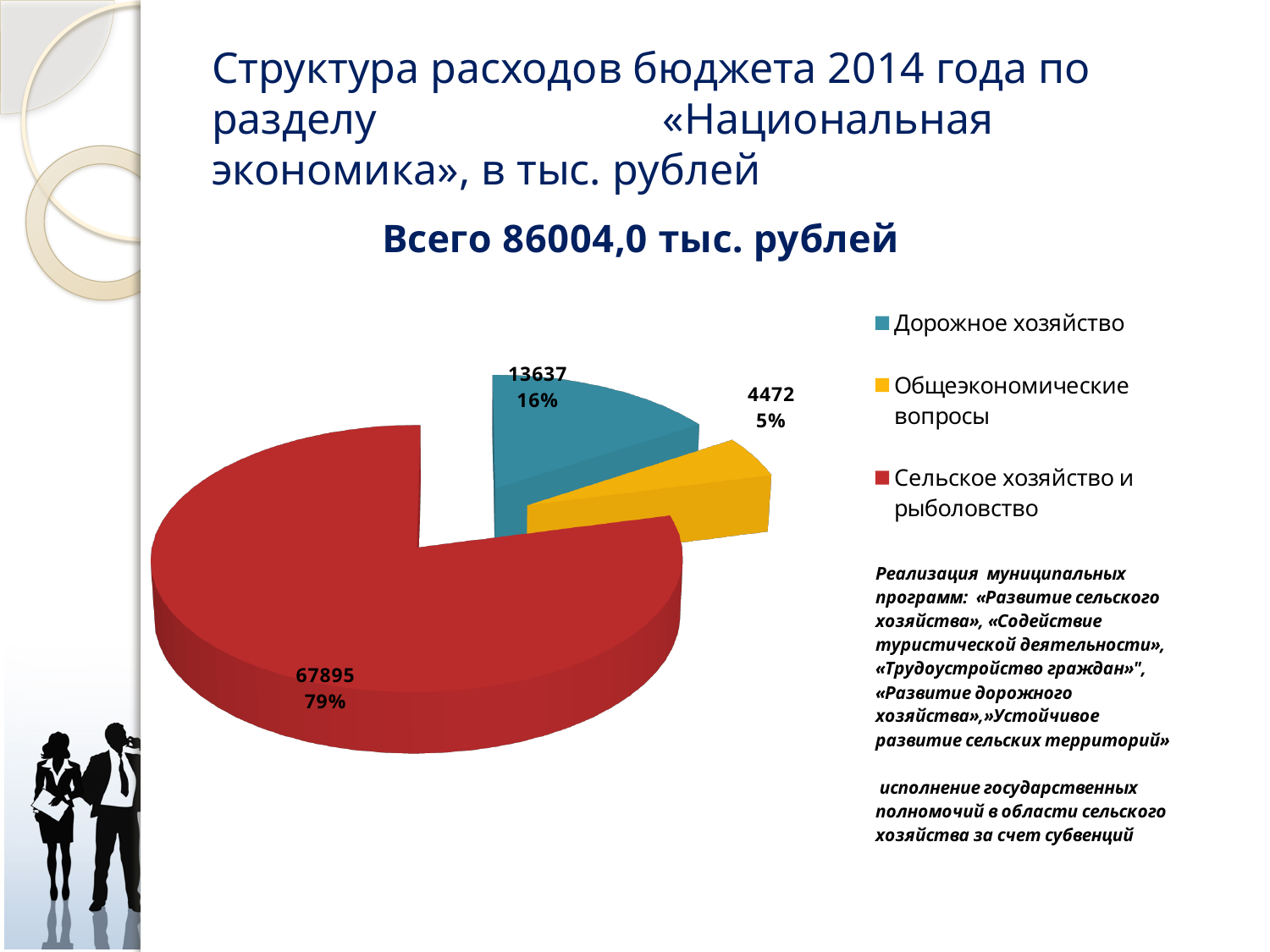
Which category has the largest slice of the pie? Сельское хозяйство и рыболовство How many categories does the pie chart have? 3 What share of the pie does Сельское хозяйство и рыболовство represent? 79% What is the difference between the values for Дорожное хозяйство and Общеэкономические вопросы? 9165 Which category has the smallest slice of the pie? Общеэкономические вопросы What share of the pie does Дорожное хозяйство represent? 16% What is the value for Общеэкономические вопросы? 4472 Which is larger: the value for Дорожное хозяйство or the value for Общеэкономические вопросы? Дорожное хозяйство What type of chart is shown on the slide? Pie chart What colour is the slice for Сельское хозяйство и рыболовство? Red What is the value for Дорожное хозяйство? 13637 What is the value for Сельское хозяйство и рыболовство? 67895